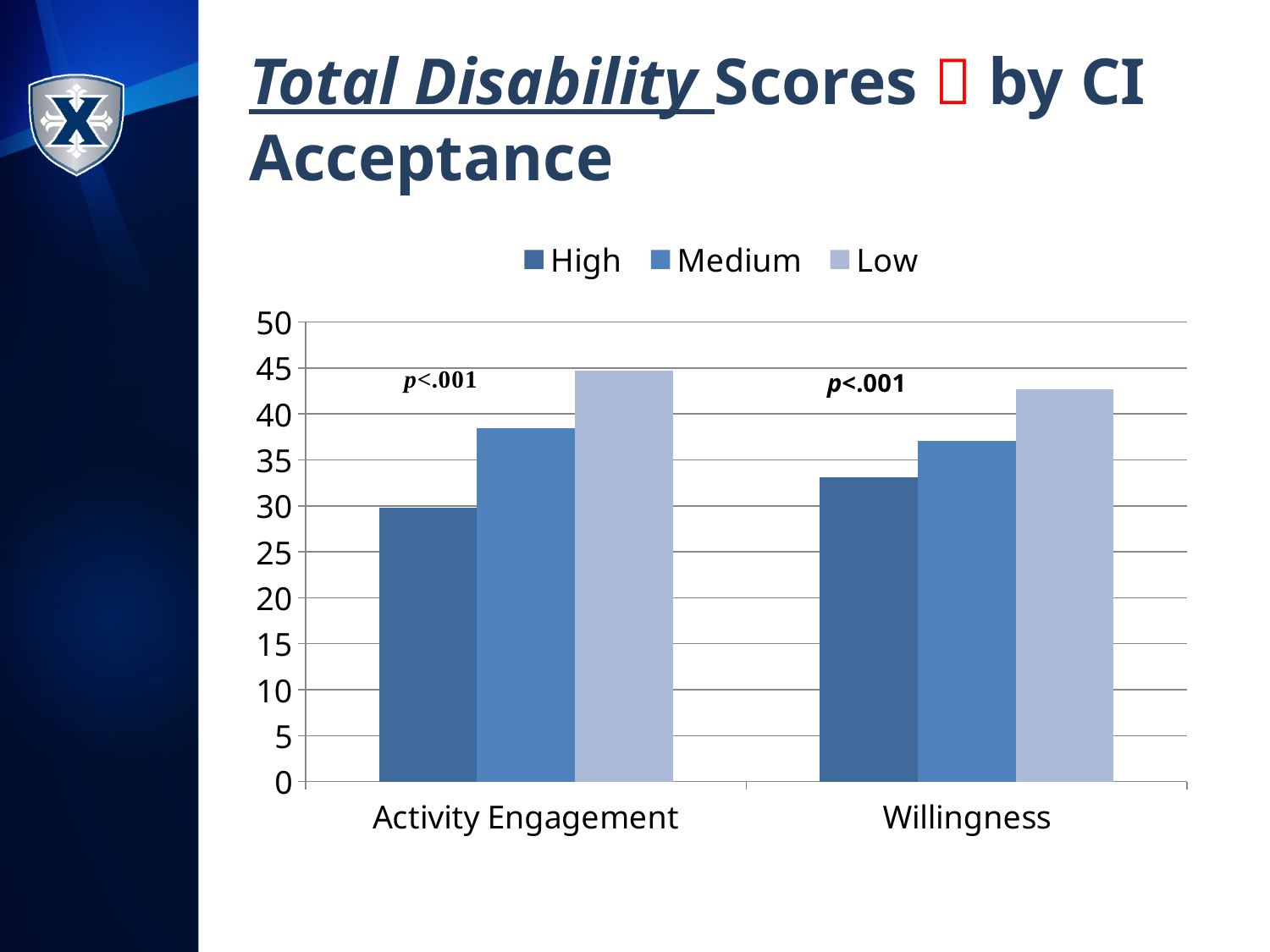
Which series has the lowest bar in the Willingness category? High Which is larger: the High bar for Activity Engagement or the High bar for Willingness? Willingness Is the value for Medium in Activity Engagement greater or less than 35? greater How many series does the legend list? 3 Which series has the highest bar in the Activity Engagement category? Low What are the three legend entries of the chart? High, Medium, Low What p-value annotation is shown above each category group? p<.001 How many categories are shown on the x axis? 2 Is the value for High in Willingness greater or less than 30? greater What kind of chart is shown on the slide? bar chart Is the value for Medium in Willingness greater or less than 40? less